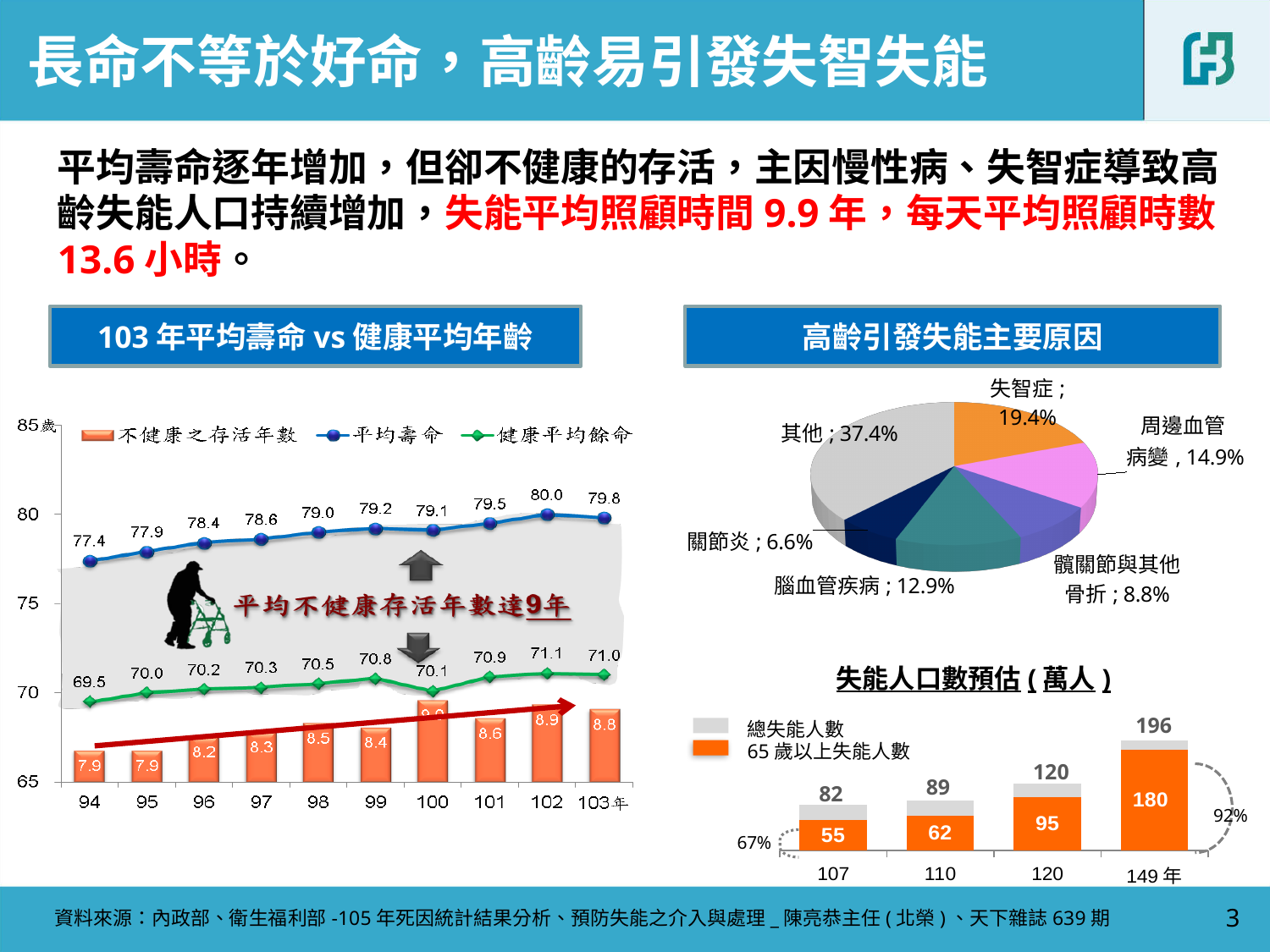
In the chart titled 失能人口數預估(萬人), what is the 總失能人數 value for 149年? 196 In the chart titled 103年平均壽命 vs 健康平均年齡, in which year is 平均壽命 highest? 102 In the chart titled 失能人口數預估(萬人), what is the difference between 總失能人數 and 65歲以上失能人數 for 149年? 16 In the chart titled 103年平均壽命 vs 健康平均年齡, what is the 平均壽命 value for year 102? 80.0 In the chart titled 103年平均壽命 vs 健康平均年齡, what is the 不健康之存活年數 value for year 103? 8.8 In the chart titled 103年平均壽命 vs 健康平均年齡, what is the 健康平均餘命 value for year 94? 69.5 In the pie chart titled 高齡引發失能主要原因, how many categories are shown? 6 In the pie chart titled 高齡引發失能主要原因, which category has the largest share? 其他 In the pie chart titled 高齡引發失能主要原因, which category has the smallest share? 關節炎 In the pie chart titled 高齡引發失能主要原因, what share does 失智症 have? 19.4% In the chart titled 103年平均壽命 vs 健康平均年齡, what is the difference between the 平均壽命 values for year 102 and year 94? 2.6 In the chart titled 103年平均壽命 vs 健康平均年齡, how many series does the legend list? 3